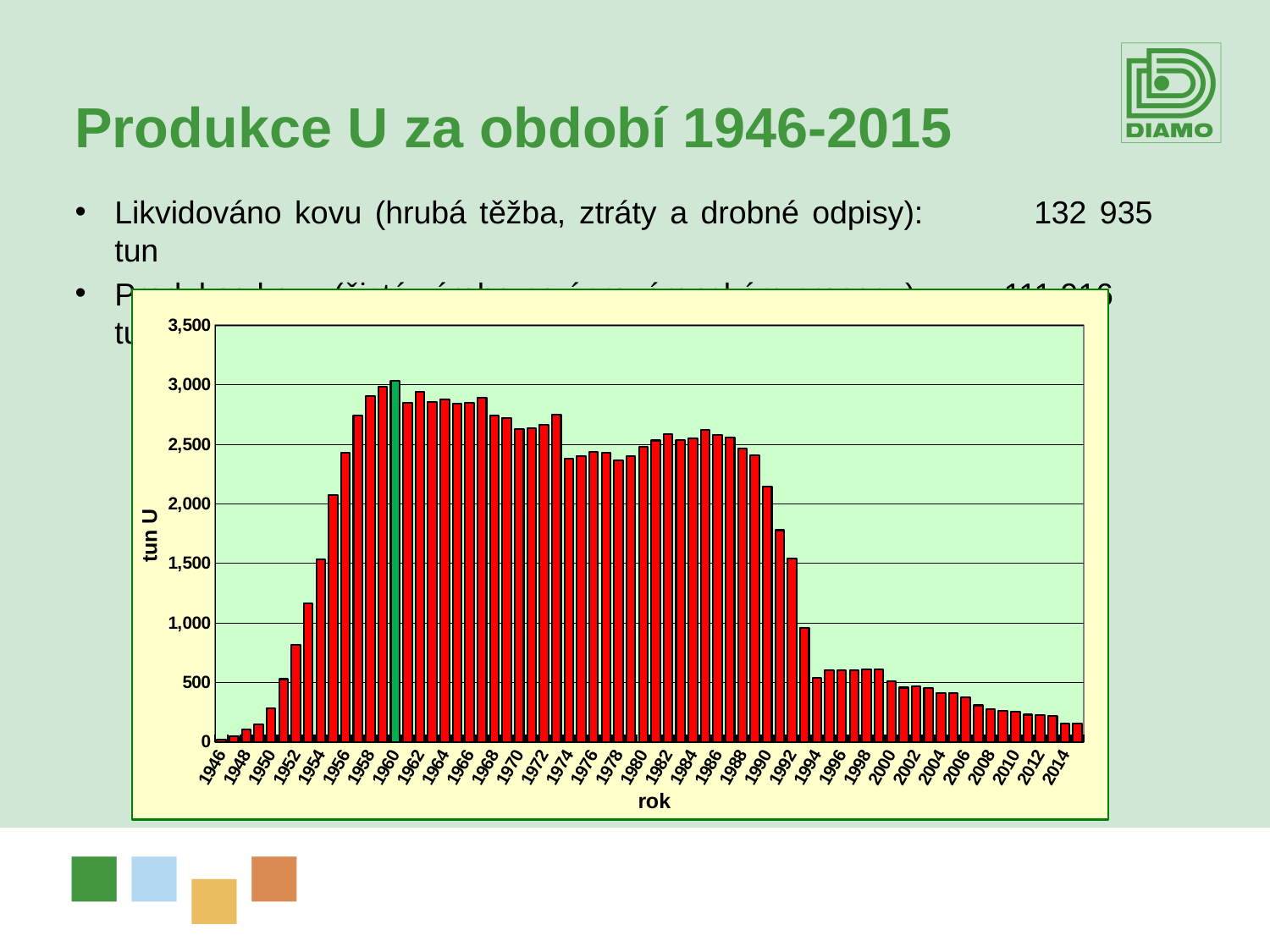
What is the title of the vertical axis of the chart? tun U Is the value for 2014 greater or less than 500? less Which year has the lowest uranium production in the chart? 1946 Is the value for 1952 greater or less than 500? greater Is the value for 1990 greater or less than 2,000? greater Which year has the larger value, 1960 or 1990? 1960 Which year has the highest uranium production in the chart? 1960 What kind of chart is shown on the slide? bar chart Which year has the larger value, 1954 or 1994? 1954 Do the values rise or fall from 1990 to 2014? fall